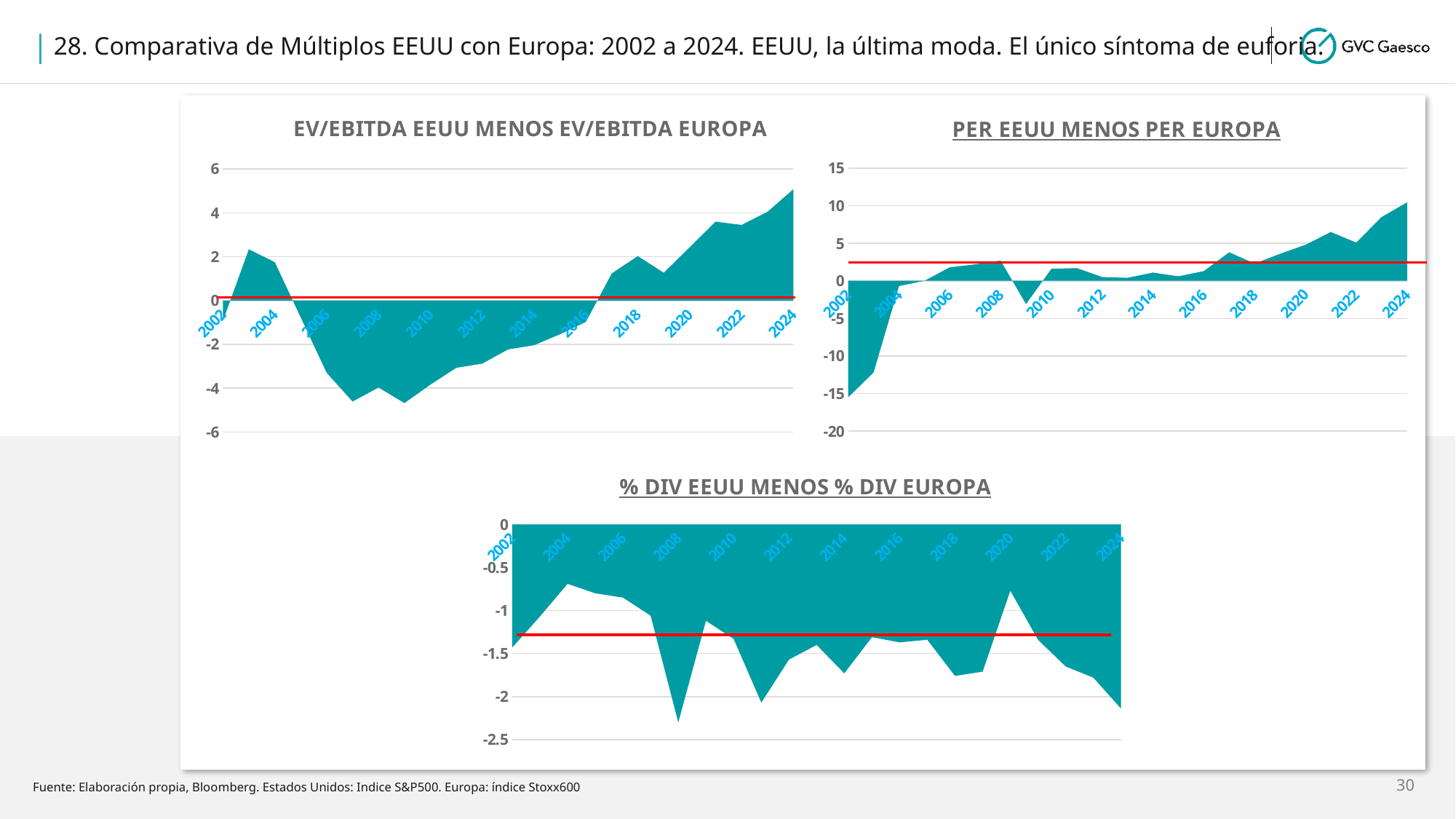
In the 'EV/EBITDA EEUU MENOS EV/EBITDA EUROPA' chart, which is larger, the value for 2004 or the value for 2024? 2024 In the 'PER EEUU MENOS PER EUROPA' chart, is the value for 2002 greater or less than -10? less In the '% DIV EEUU MENOS % DIV EUROPA' chart, which year has the lowest value? 2008 In the 'PER EEUU MENOS PER EUROPA' chart, do the values generally rise or fall from 2016 to 2024? rise How many charts are shown on the slide? 3 What kind of chart is the 'EV/EBITDA EEUU MENOS EV/EBITDA EUROPA' chart? Area chart In the 'EV/EBITDA EEUU MENOS EV/EBITDA EUROPA' chart, is the value for 2024 greater or less than 4? greater What is the title of the chart at the bottom of the slide? % DIV EEUU MENOS % DIV EUROPA In the 'PER EEUU MENOS PER EUROPA' chart, which year has the lowest value? 2002 In the 'EV/EBITDA EEUU MENOS EV/EBITDA EUROPA' chart, which year has the highest value? 2024 In the 'PER EEUU MENOS PER EUROPA' chart, which year has the highest value? 2024